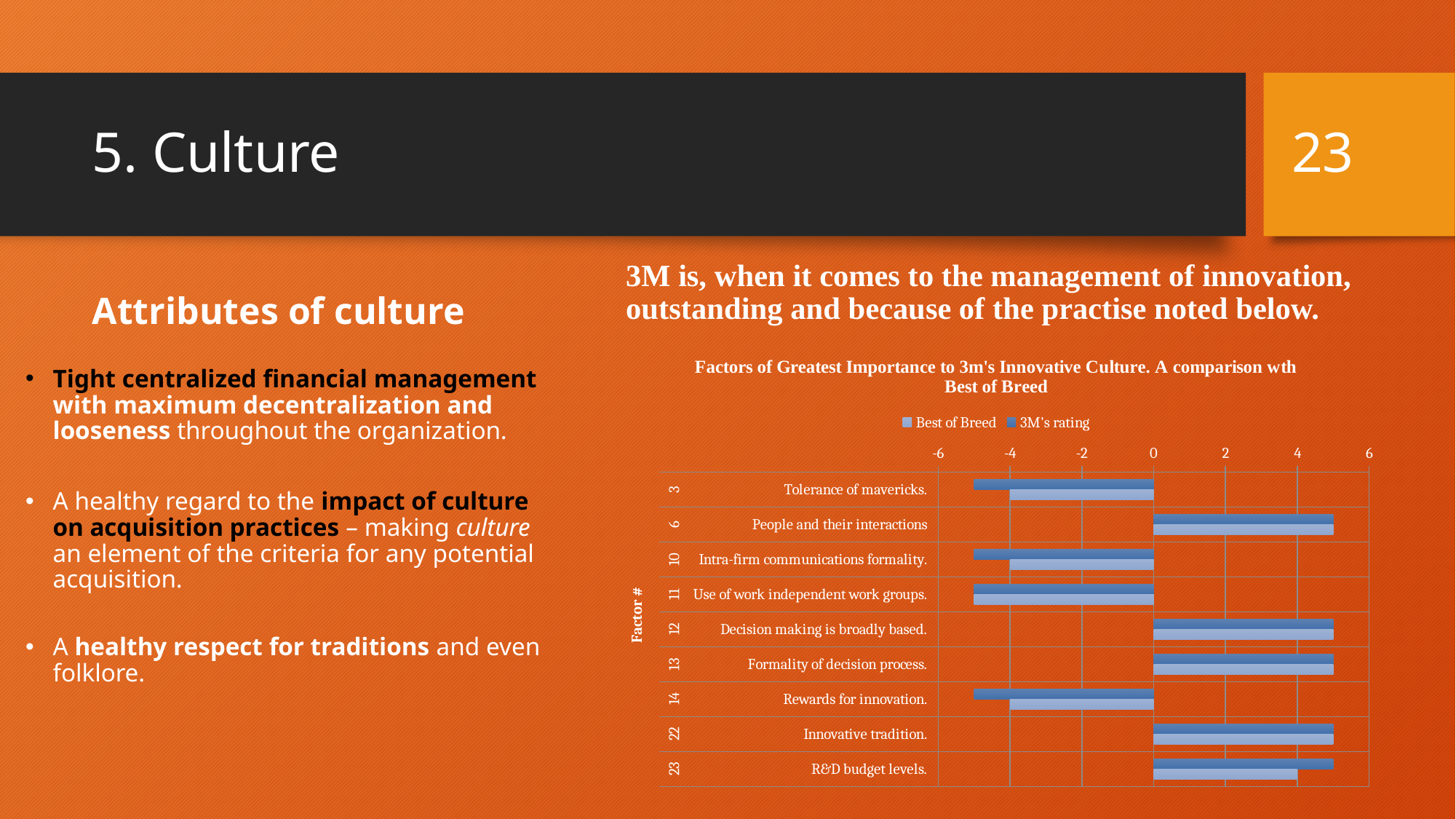
For 'R&D budget levels', which series has the larger value, Best of Breed or 3M's rating? 3M's rating How many factors (categories) are plotted in the chart? 9 Is the 3M's rating value for 'Decision making is broadly based' greater or less than 0? greater Is the 3M's rating value for 'People and their interactions' greater or less than 4? greater Is the 3M's rating value for 'Tolerance of mavericks' greater or less than -4? less What kind of chart is shown on the slide? bar chart How many series does the chart's legend list? 2 For 'Rewards for innovation', which series has the lower (more negative) value, Best of Breed or 3M's rating? 3M's rating What are the two series named in the chart's legend? Best of Breed and 3M's rating What is the title of the chart? Factors of Greatest Importance to 3m's Innovative Culture. A comparison wth Best of Breed